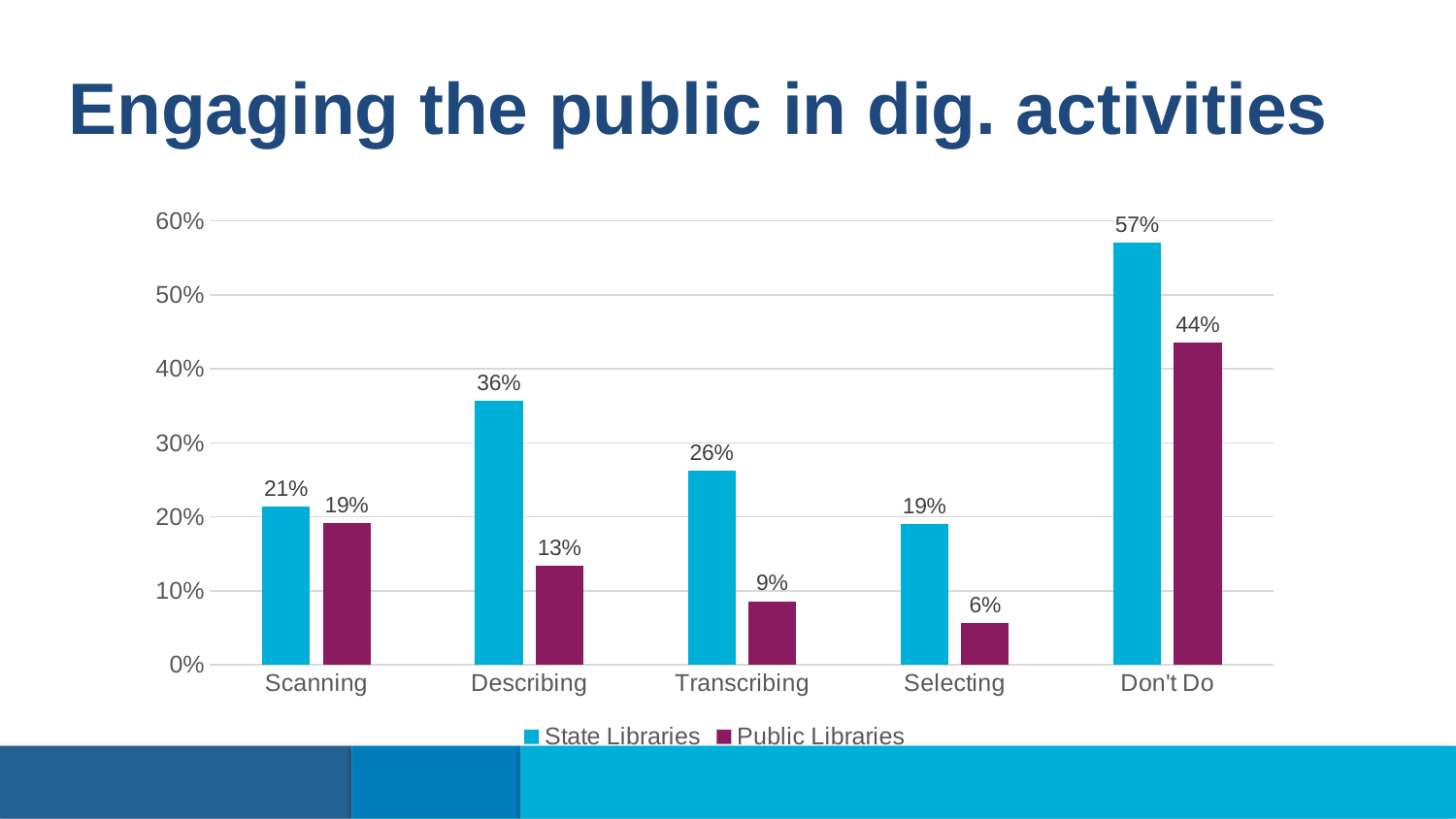
What is the difference between State Libraries and Public Libraries in the Transcribing category? 17% Which category has the highest value for State Libraries? Don't Do How many categories are shown on the x axis? 5 How many series does the legend list? 2 What kind of chart is shown on the slide? Bar chart What is the value for Public Libraries in the Selecting category? 6% Which is larger: State Libraries for Scanning or Public Libraries for Scanning? State Libraries for Scanning What is the value for Public Libraries in the Don't Do category? 44% Which series is shown in purple? Public Libraries Which category has the lowest value for Public Libraries? Selecting What is the value for State Libraries in the Describing category? 36% What is the title of the slide? Engaging the public in dig. activities